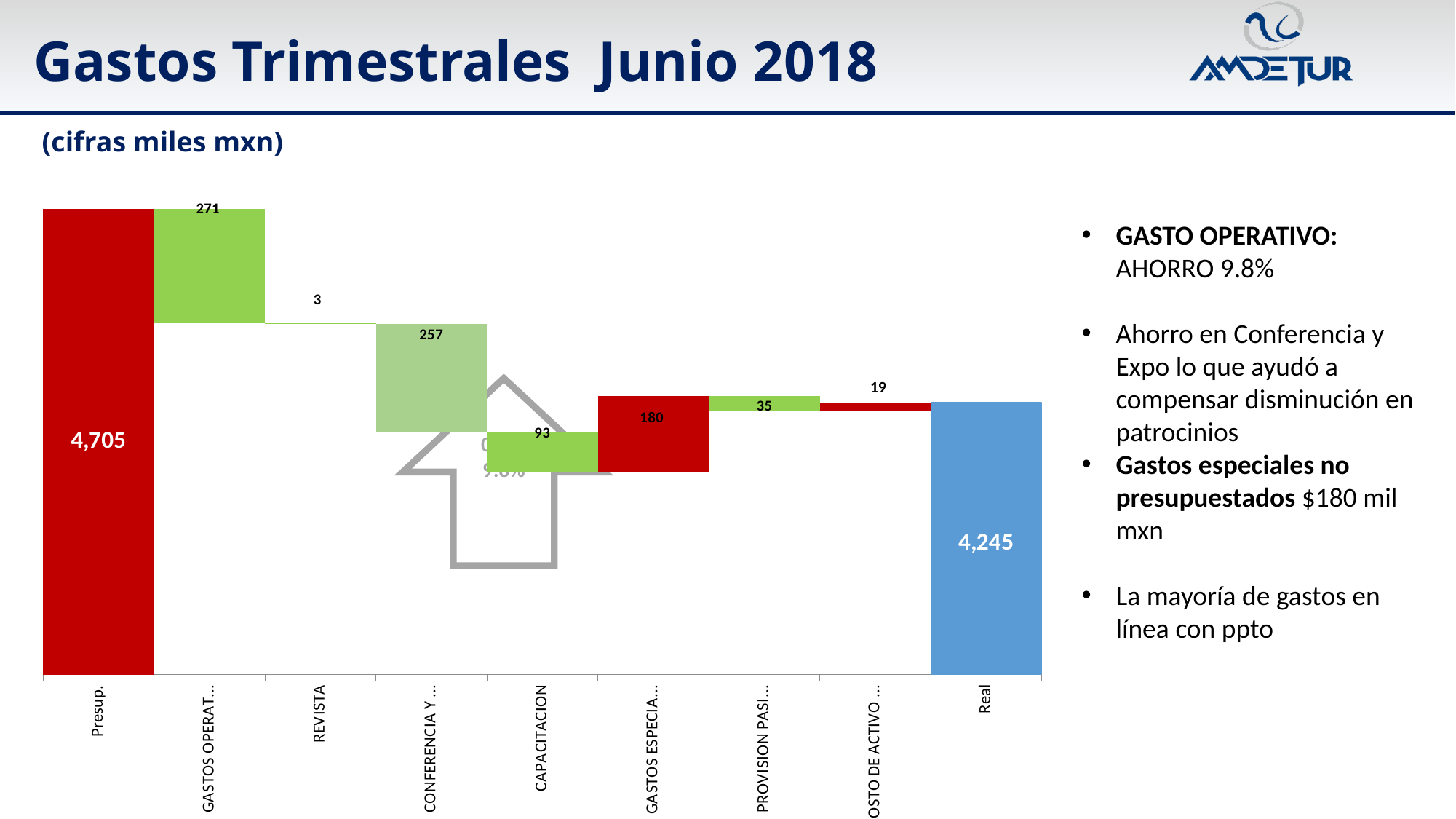
What value is shown for CAPACITACION? 93 What is the value of the Presup. bar? 4,705 What is the value of the Real bar? 4,245 Which is larger, the value for GASTOS OPERAT... or the value for CONFERENCIA Y ...? GASTOS OPERAT... What value is shown for GASTOS ESPECIA...? 180 How many categories are shown on the x axis of the chart? 9 What kind of chart is shown on the slide? Waterfall bar chart Which of the intermediate steps (excluding Presup. and Real) has the smallest value? REVISTA What colour is the Real bar? Blue What value is shown for REVISTA? 3 What is the difference between the Presup. value and the Real value? 460 What value is shown for PROVISION PASI...? 35